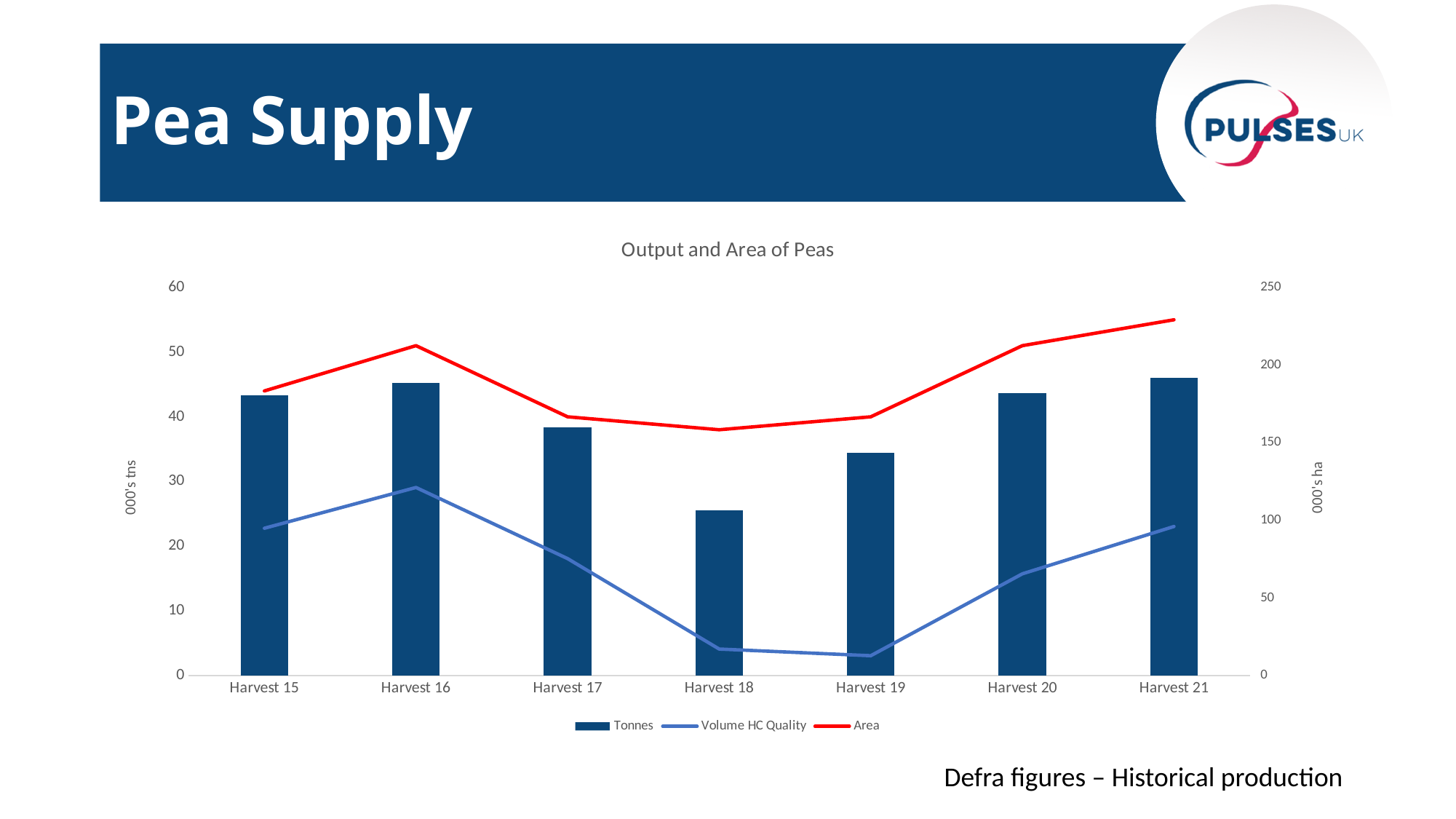
Does the Area line rise or fall from Harvest 18 to Harvest 21? rise How many harvest years are shown on the x axis? 7 Which has the larger Tonnes bar, Harvest 17 or Harvest 18? Harvest 17 Which harvest has the highest value on the Area line? Harvest 21 Which harvest has the lowest Tonnes bar? Harvest 18 Is the Tonnes value for Harvest 16 greater or less than 40? greater Which harvest has the lowest value on the Volume HC Quality line? Harvest 19 What kind of chart is this? Combined bar and line chart What is the title of the chart? Output and Area of Peas How many series does the chart legend list? 3 Is the Area value for Harvest 21 greater or less than 200 on the right axis? greater